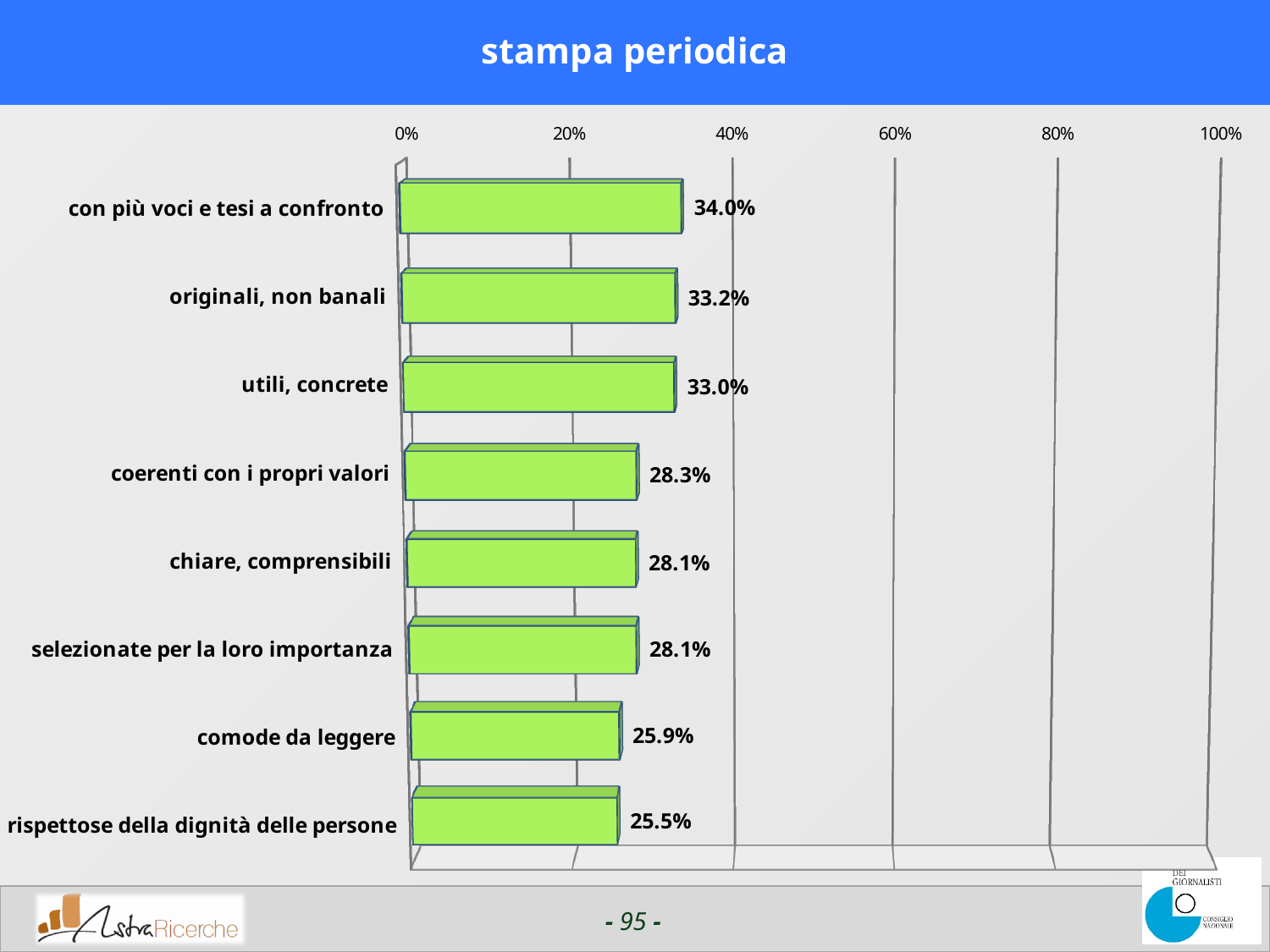
How many categories are shown in the chart? 8 What is the value for "comode da leggere"? 25.9% What is the value for "coerenti con i propri valori"? 28.3% What is the difference between the values for "con più voci e tesi a confronto" and "rispettose della dignità delle persone"? 8.5% What is the value for "con più voci e tesi a confronto"? 34.0% What kind of chart is shown on the slide? bar chart Which category has the lowest value? rispettose della dignità delle persone Is the value for "con più voci e tesi a confronto" greater or less than 40%? less Which category has the highest value? con più voci e tesi a confronto What is the title of the slide? stampa periodica Which is larger, the value for "utili, concrete" or the value for "chiare, comprensibili"? utili, concrete What is the difference between the values for "originali, non banali" and "utili, concrete"? 0.2%